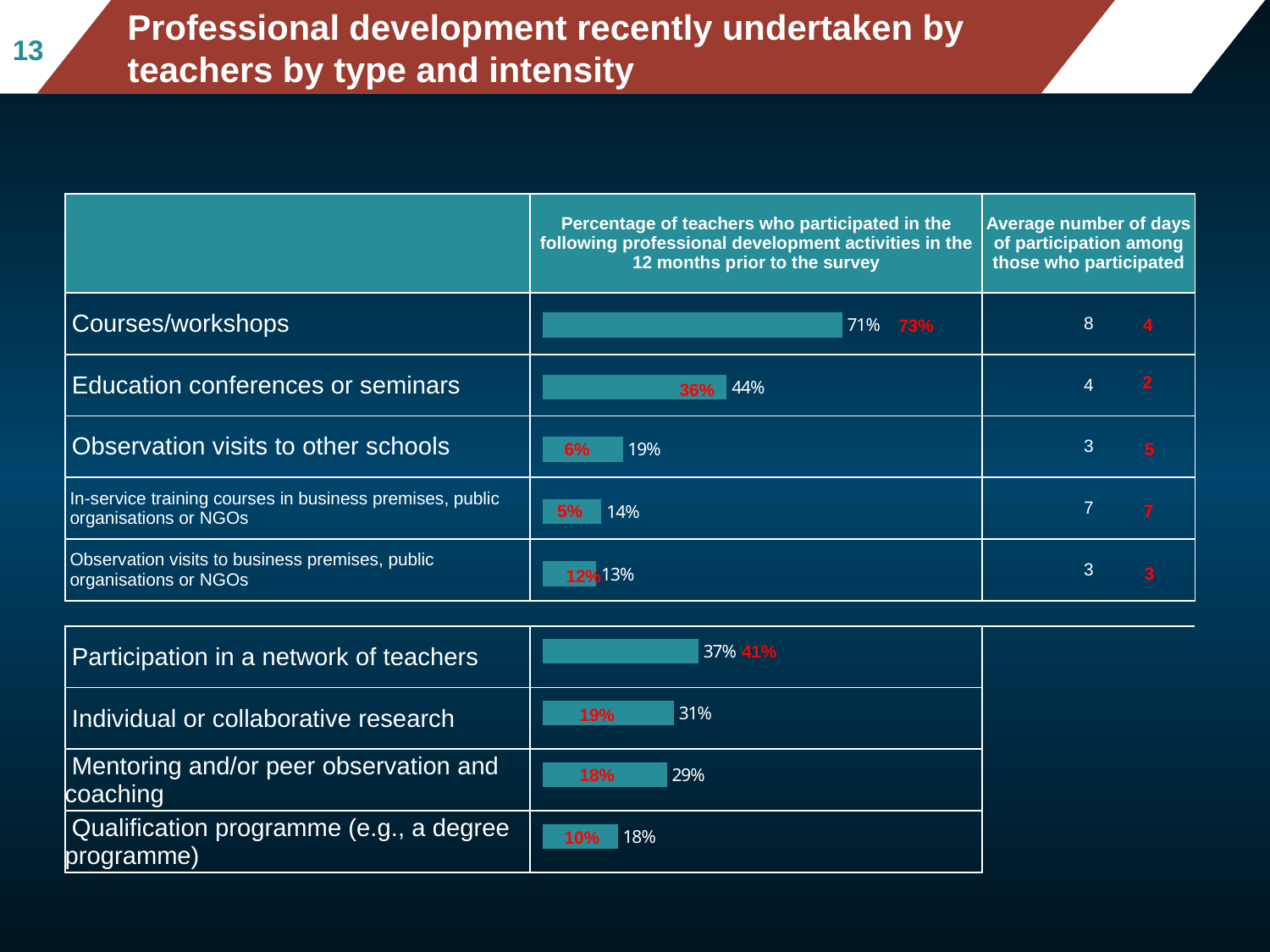
What percentage of teachers participated in courses/workshops, as shown by the bar label? 71% Which professional development activity has the longest bar? Courses/workshops Which activity in the lower table has the shortest bar? Qualification programme (e.g., a degree programme) What is the red value shown for courses/workshops? 73% What is the title of the slide? Professional development recently undertaken by teachers by type and intensity Which has a longer bar: individual or collaborative research, or mentoring and/or peer observation and coaching? Individual or collaborative research What percentage of teachers participated in education conferences or seminars, as shown by the bar label? 44% What percentage of teachers participated in a network of teachers, as shown by the bar label? 37% What is the average number of days of participation for courses/workshops, as shown in the white figure? 8 How many professional development activities are listed across both tables? 9 What kind of chart is used to show the percentages in the table? Bar chart What is the difference between the bar values for courses/workshops (71%) and education conferences or seminars (44%)? 27%